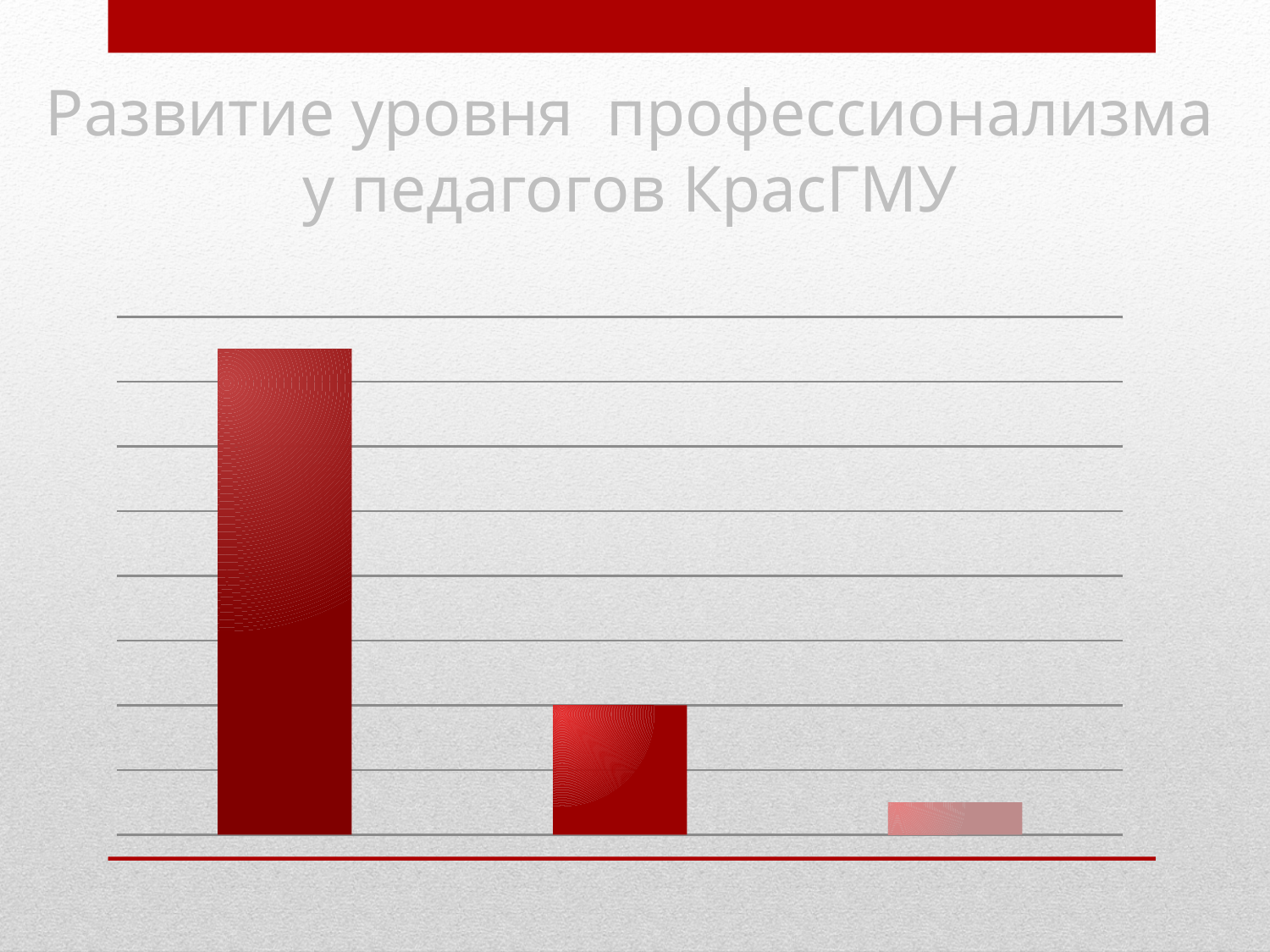
What is the title shown above the chart on the slide? Развитие уровня профессионализма у педагогов КрасГМУ What kind of chart is shown on the slide? bar chart Is the left bar taller or shorter than the middle bar? taller What colour are the bars in the chart? red Which bar is the shortest: the left, middle or right one? right Do the bar heights rise or fall from left to right? fall How many bars does the chart show? 3 Is the right bar taller or shorter than the middle bar? shorter Which bar is the tallest: the left, middle or right one? left